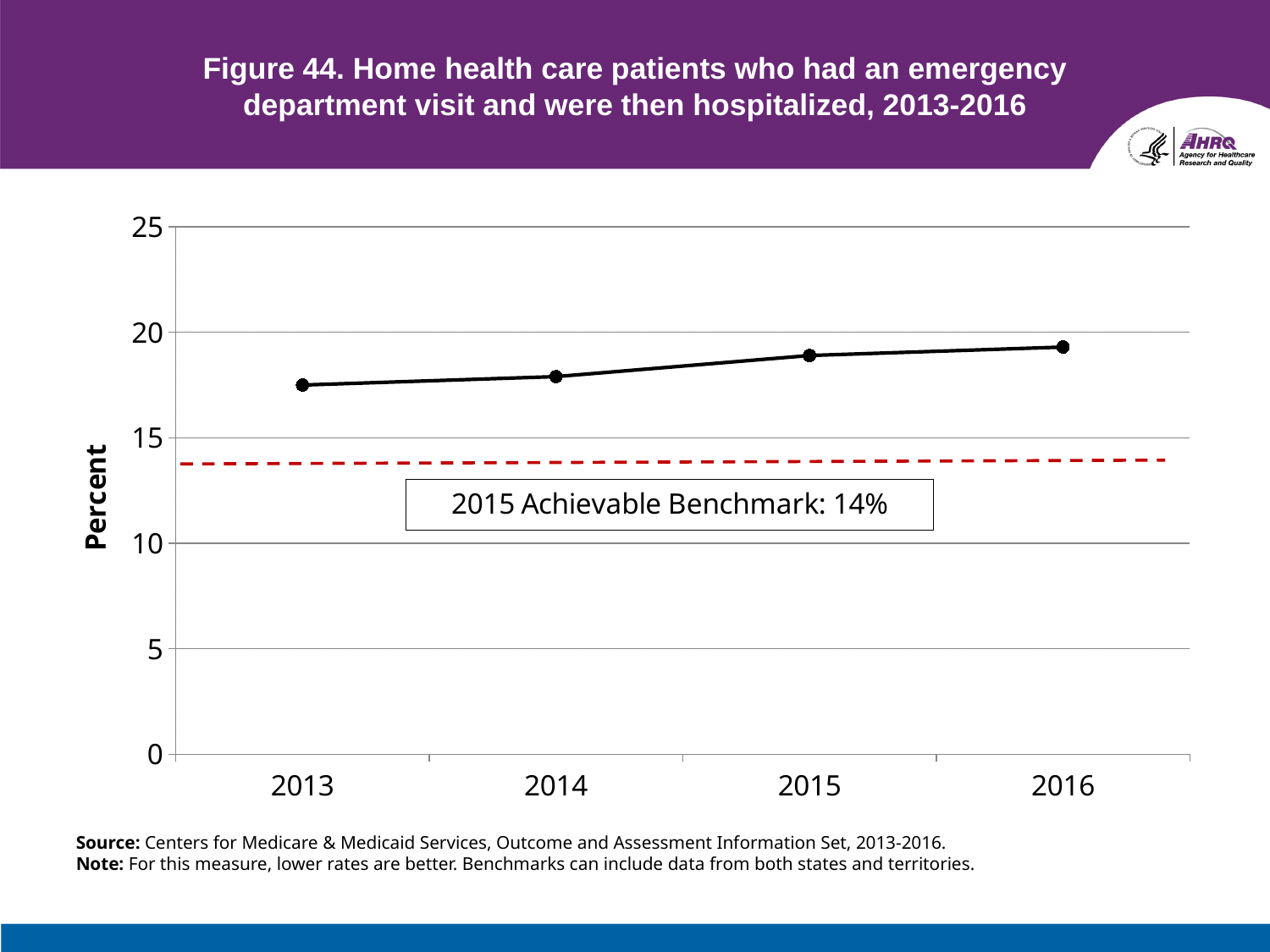
What kind of chart is shown on the slide? line chart Is the value for 2015 greater or less than 20? less What is the label on the y axis? Percent Which year has the larger value, 2014 or 2015? 2015 Is the value for 2013 greater or less than 15? greater How many years are plotted on the x axis? 4 Which year has the larger value, 2013 or 2016? 2016 What is the highest value shown on the y axis? 25 Is the value for 2014 greater or less than 15? greater What is the 2015 Achievable Benchmark shown on the chart? 14% Do the plotted values rise or fall from 2013 to 2016? rise